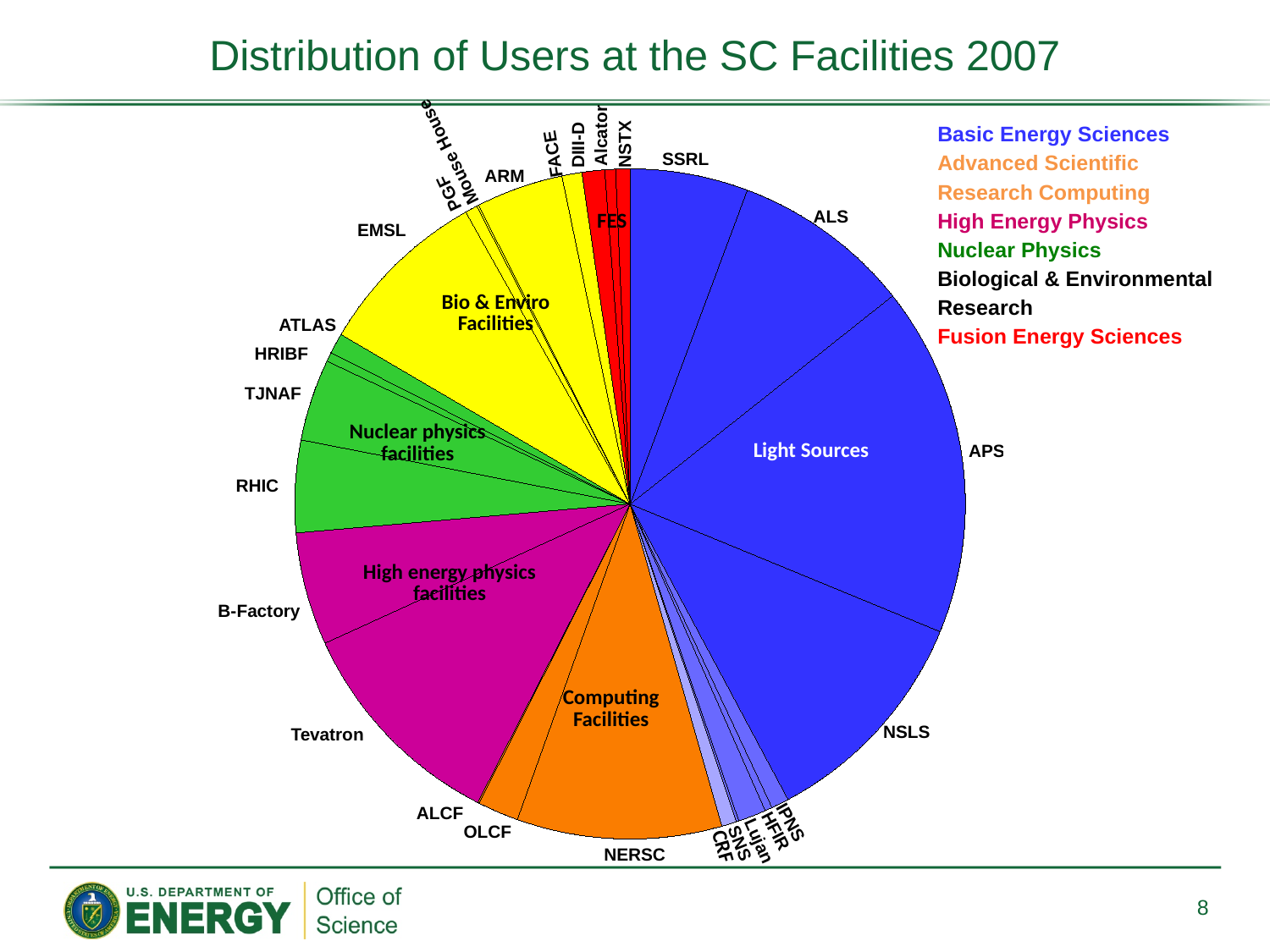
Which slice is larger, APS or NSLS? APS What colour are the Computing Facilities slices? orange Which slice is larger, Tevatron or RHIC? Tevatron What is the title of the chart? Distribution of Users at the SC Facilities 2007 Which slice is larger, NERSC or OLCF? NERSC What kind of chart is shown on the slide? pie chart Which program office has the smallest share of the pie? Fusion Energy Sciences How many program offices does the legend list? 6 Which single facility has the largest slice of the pie? APS Which facility group takes the largest share of the pie? Light Sources